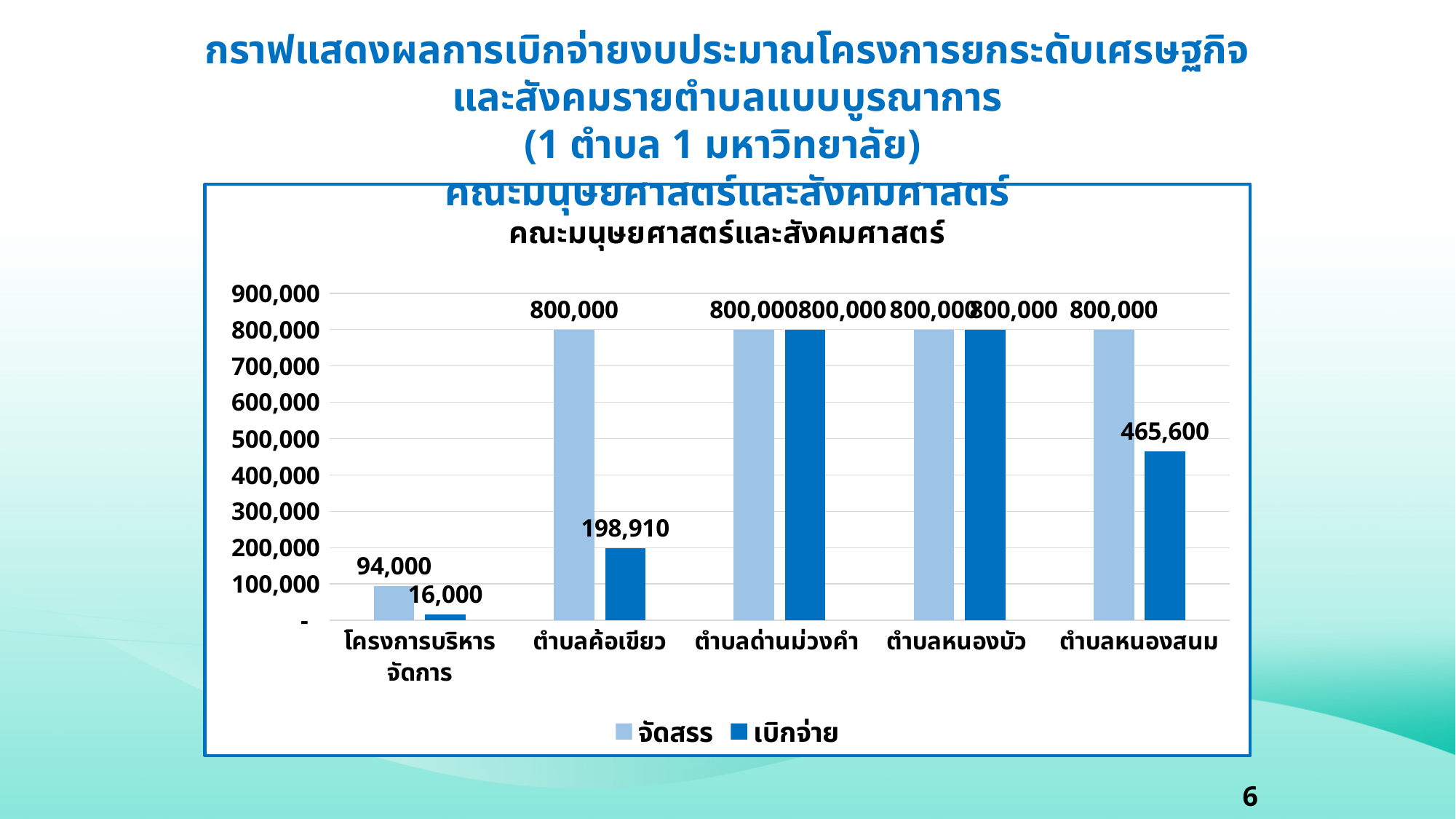
What is the title of the chart? คณะมนุษยศาสตร์และสังคมศาสตร์ What type of chart is shown on the slide? bar chart What is the เบิกจ่าย value for โครงการบริหารจัดการ? 16,000 What is the จัดสรร value for โครงการบริหารจัดการ? 94,000 How many series does the legend list? 2 Which is larger, the เบิกจ่าย value for ตำบลหนองสนม or the เบิกจ่าย value for ตำบลค้อเขียว? ตำบลหนองสนม What is the เบิกจ่าย value for ตำบลค้อเขียว? 198,910 Which category has the lowest เบิกจ่าย value? โครงการบริหารจัดการ What is the difference between the จัดสรร and เบิกจ่าย values for ตำบลค้อเขียว? 601,090 What is the เบิกจ่าย value for ตำบลหนองสนม? 465,600 How many categories are shown on the x axis? 5 What is the difference between the จัดสรร and เบิกจ่าย values for ตำบลหนองสนม? 334,400